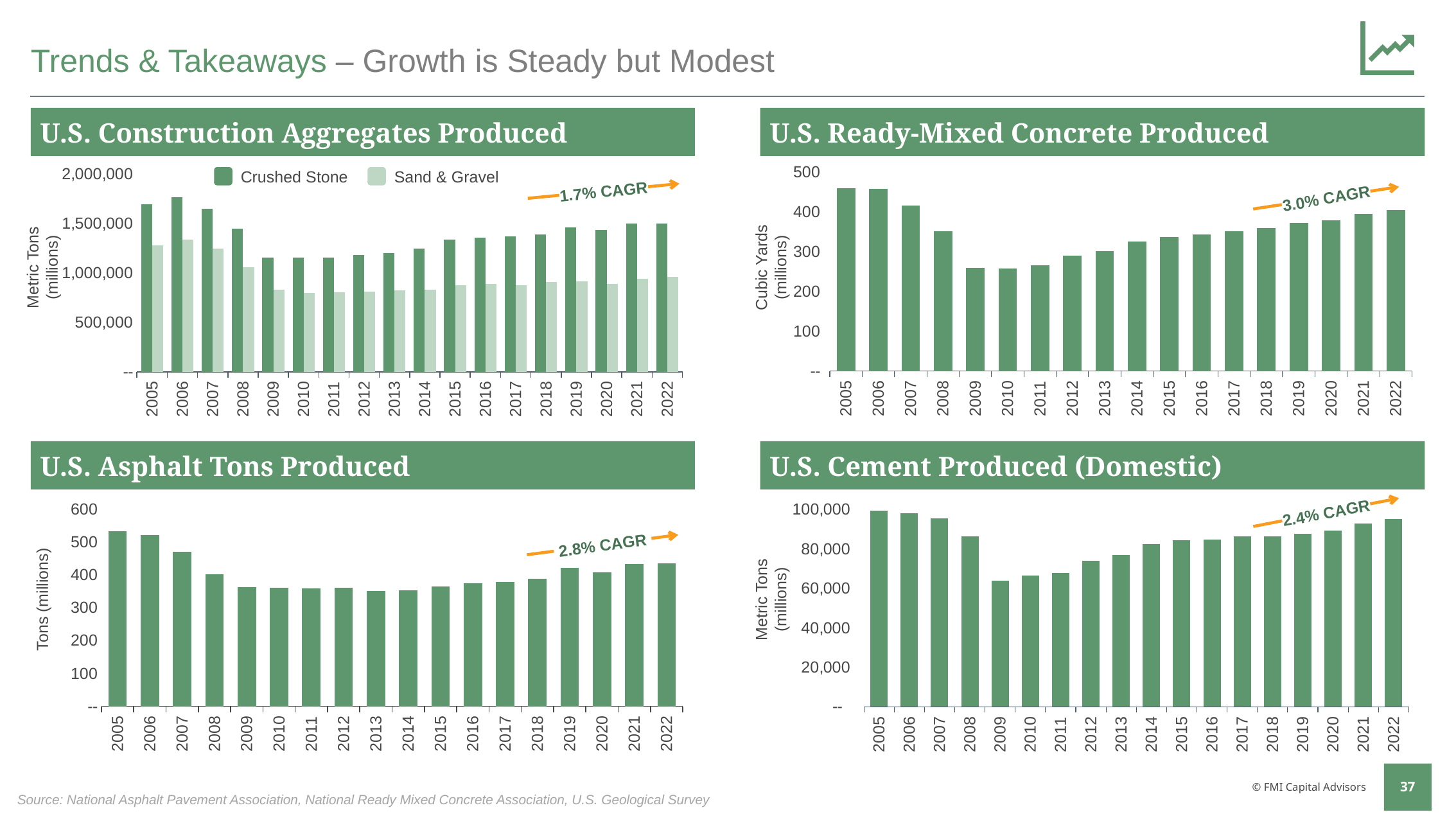
In the U.S. Construction Aggregates Produced chart, which series has the larger value in 2022, Crushed Stone or Sand & Gravel? Crushed Stone What kind of chart is the U.S. Ready-Mixed Concrete Produced chart? bar chart What CAGR is annotated on the U.S. Cement Produced (Domestic) chart? 2.4% CAGR How many series does the legend of the U.S. Construction Aggregates Produced chart list? 2 In the U.S. Construction Aggregates Produced chart, is the Sand & Gravel value for 2010 greater or less than 1,000,000? less In the U.S. Ready-Mixed Concrete Produced chart, do values rise or fall from 2010 to 2022? rise In the U.S. Construction Aggregates Produced chart, is the Crushed Stone value for 2006 greater or less than 1,500,000? greater In the U.S. Cement Produced (Domestic) chart, which year has the lowest value? 2009 How many years are shown on the x axis of the U.S. Asphalt Tons Produced chart? 18 In the U.S. Ready-Mixed Concrete Produced chart, is the value for 2009 greater or less than 300? less In the U.S. Asphalt Tons Produced chart, do values rise or fall from 2005 to 2009? fall